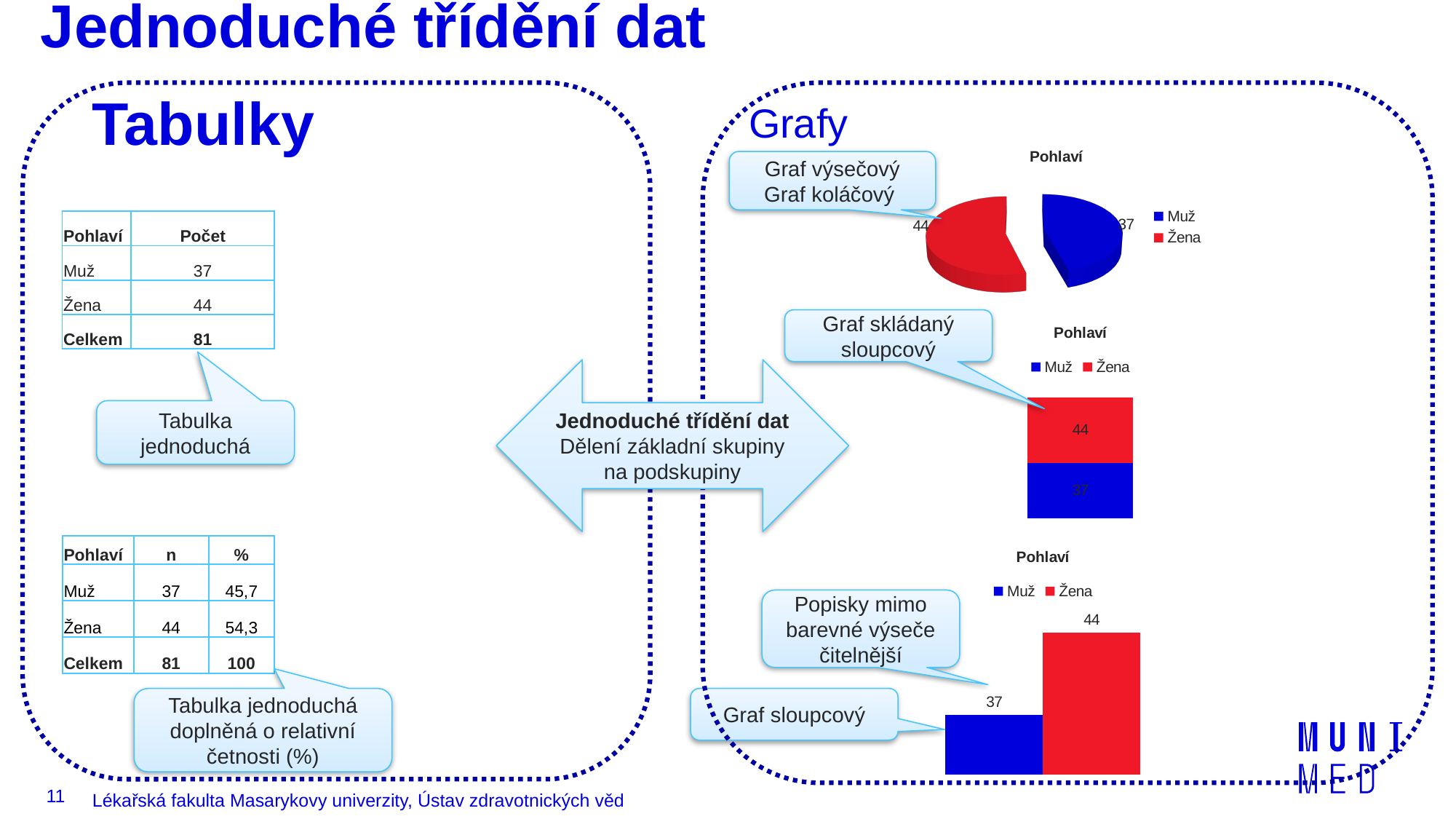
How many entries does the legend of the pie chart at the top right list? 2 In the pie chart at the top right, which category has the larger slice? Žena In the bar chart at the bottom right, which is larger, Muž or Žena? Žena In the pie chart at the top right, what is the value for Muž? 37 How many bars are shown in the bar chart at the bottom right? 2 In the stacked bar chart in the middle right, what is the total of the stacked bar? 81 In the bar chart at the bottom right, what is the difference between the values for Žena and Muž? 7 In the stacked bar chart in the middle right, which colour represents Žena? Red In the pie chart at the top right, what is the value for Žena? 44 What is the title of the pie chart at the top right? Pohlaví In the stacked bar chart in the middle right, what is the value of the Muž segment? 37 What kind of chart is the chart at the bottom right? Bar chart